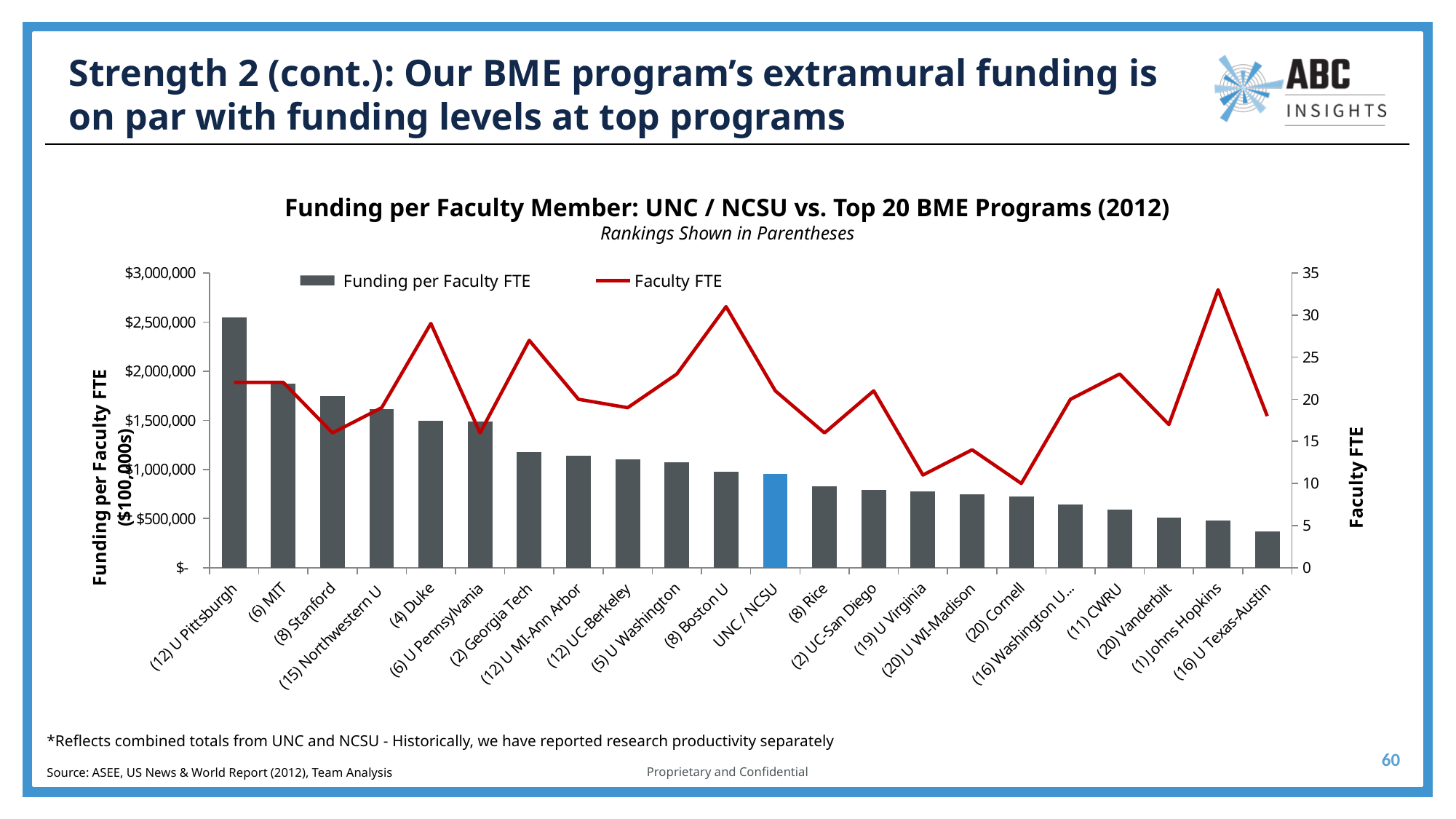
Which has higher Funding per Faculty FTE, (4) Duke or (2) Georgia Tech? (4) Duke Do the Funding per Faculty FTE bars generally rise or fall from left to right along the x axis? fall How many series does the legend list? 2 Which program has the lowest Funding per Faculty FTE? (16) U Texas-Austin Is the Funding per Faculty FTE for (12) U Pittsburgh greater or less than $2,000,000? greater Is the Faculty FTE for (1) Johns Hopkins greater or less than 30? greater Which program has the highest Faculty FTE on the line series? (1) Johns Hopkins What kind of chart is shown on the slide? Combination bar and line chart Is the Funding per Faculty FTE for UNC / NCSU greater or less than $1,500,000? less Which program's bar is highlighted in blue rather than gray? UNC / NCSU How many programs (categories) are shown on the x axis? 22 Which program has the highest Funding per Faculty FTE? (12) U Pittsburgh